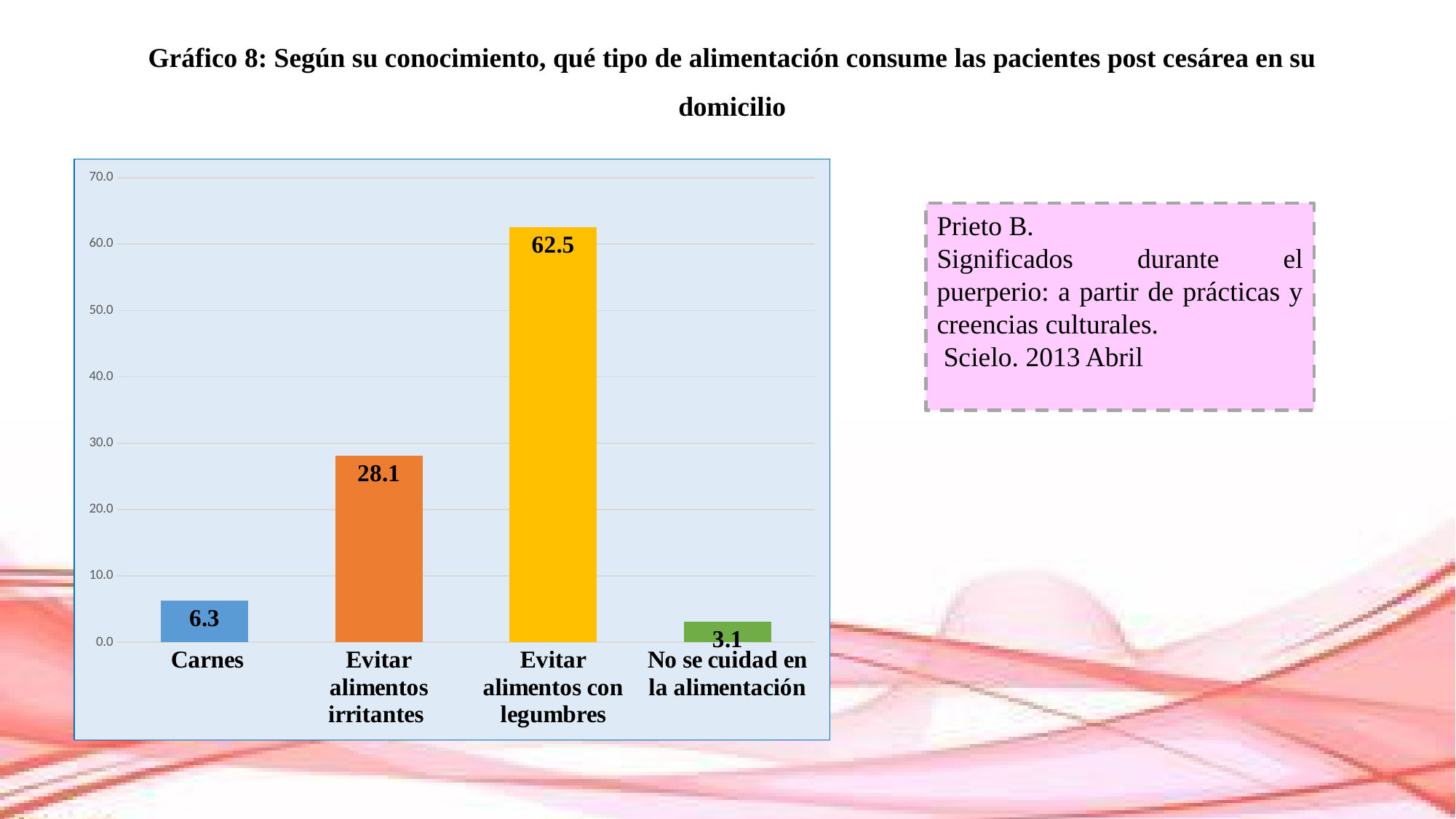
What is the difference between the values for Evitar alimentos con legumbres and Evitar alimentos irritantes? 34.4 Which category has the lowest value? No se cuidad en la alimentación Is the value for Evitar alimentos con legumbres greater or less than 60.0? greater What kind of chart is shown on the slide? bar chart What is the value for Evitar alimentos con legumbres? 62.5 Which category has the highest value? Evitar alimentos con legumbres What is the difference between the values for Carnes and No se cuidad en la alimentación? 3.2 What is the value for Carnes? 6.3 Which is larger, the value for Carnes or the value for Evitar alimentos irritantes? Evitar alimentos irritantes What is the value for No se cuidad en la alimentación? 3.1 What is the value for Evitar alimentos irritantes? 28.1 How many categories are shown in the chart? 4